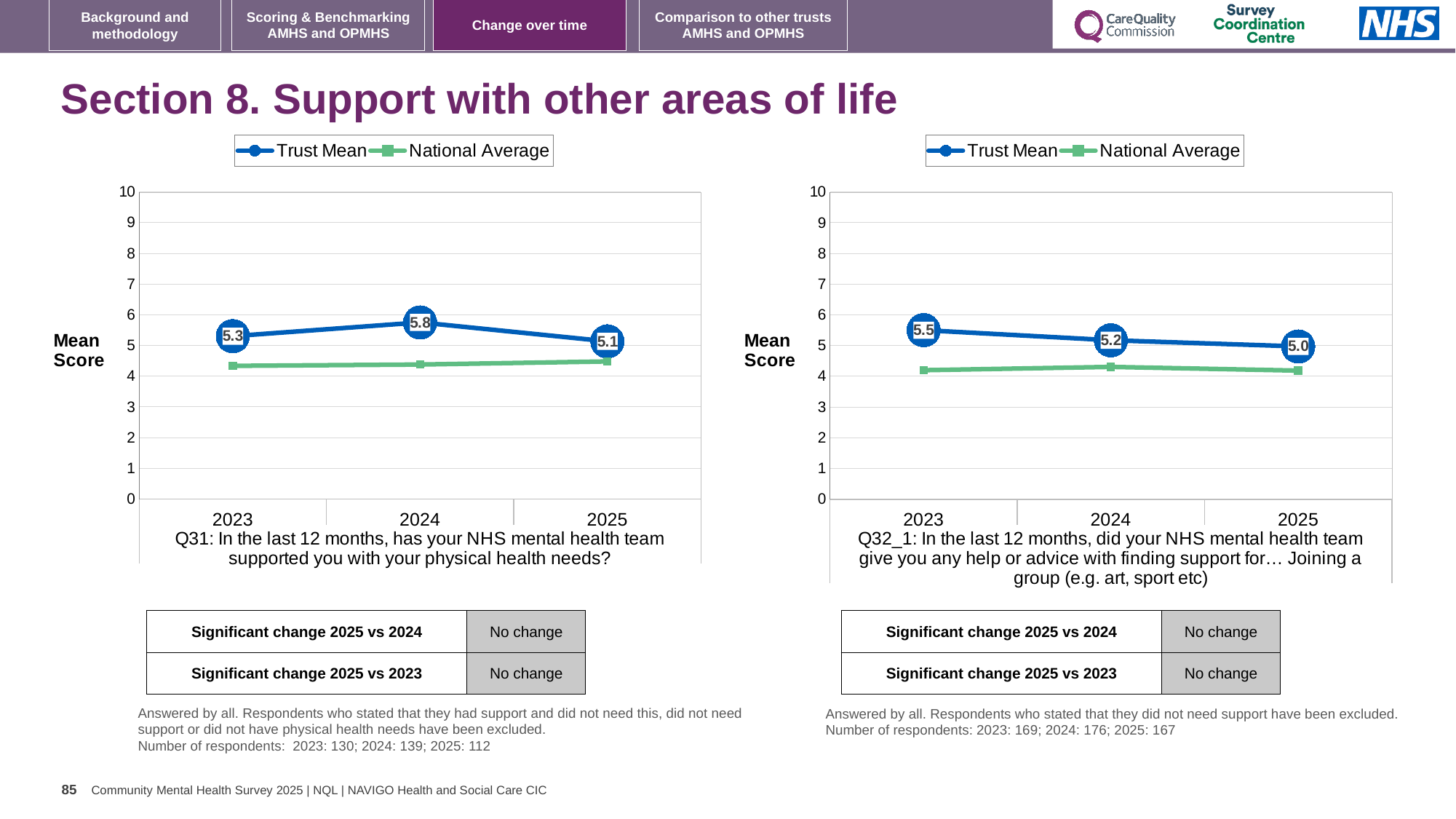
In the right chart (Q32_1), what is the difference between the Trust Mean in 2023 and in 2025? 0.5 In the right chart (Q32_1), does the Trust Mean rise or fall from 2023 to 2025? fall In the right chart (Q32_1), what is the Trust Mean for 2025? 5.0 In the left chart (Q31), which year has the highest Trust Mean? 2024 In the left chart (Q31), is the National Average for 2023 greater or less than 5? less In the left chart (Q31), what is the Trust Mean for 2024? 5.8 What kind of chart is the left chart (Q31)? line chart In the left chart (Q31), what is the Trust Mean for 2025? 5.1 How many series does the legend of the right chart (Q32_1) list? 2 In the left chart (Q31), what is the difference between the Trust Mean in 2024 and in 2025? 0.7 In the right chart (Q32_1), which year has the lowest Trust Mean? 2025 In the right chart (Q32_1), what is the Trust Mean for 2023? 5.5